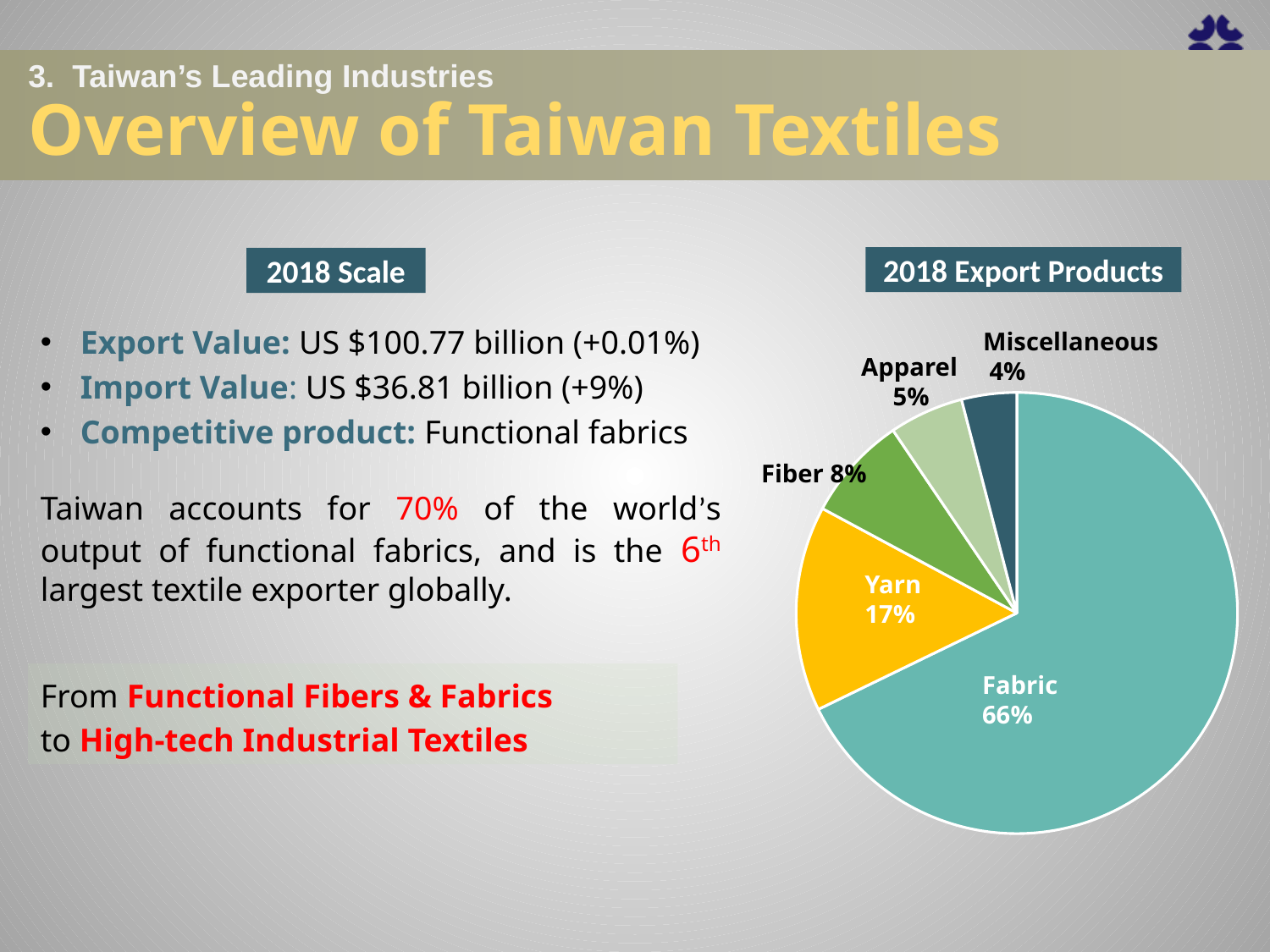
Which export product category has the smallest share in the pie chart? Miscellaneous What share of 2018 export products is Miscellaneous? 4% What share of 2018 export products is Apparel? 5% How many categories are shown in the pie chart? 5 What type of chart is shown on the slide? pie chart What share of 2018 export products is Yarn? 17% What share of 2018 export products is Fabric? 66% Which export product category has the largest share in the pie chart? Fabric Which has a larger share, Fiber or Apparel? Fiber What is the title of the pie chart? 2018 Export Products What is the difference in percentage points between the Fabric and Yarn shares? 49 What share of 2018 export products is Fiber? 8%